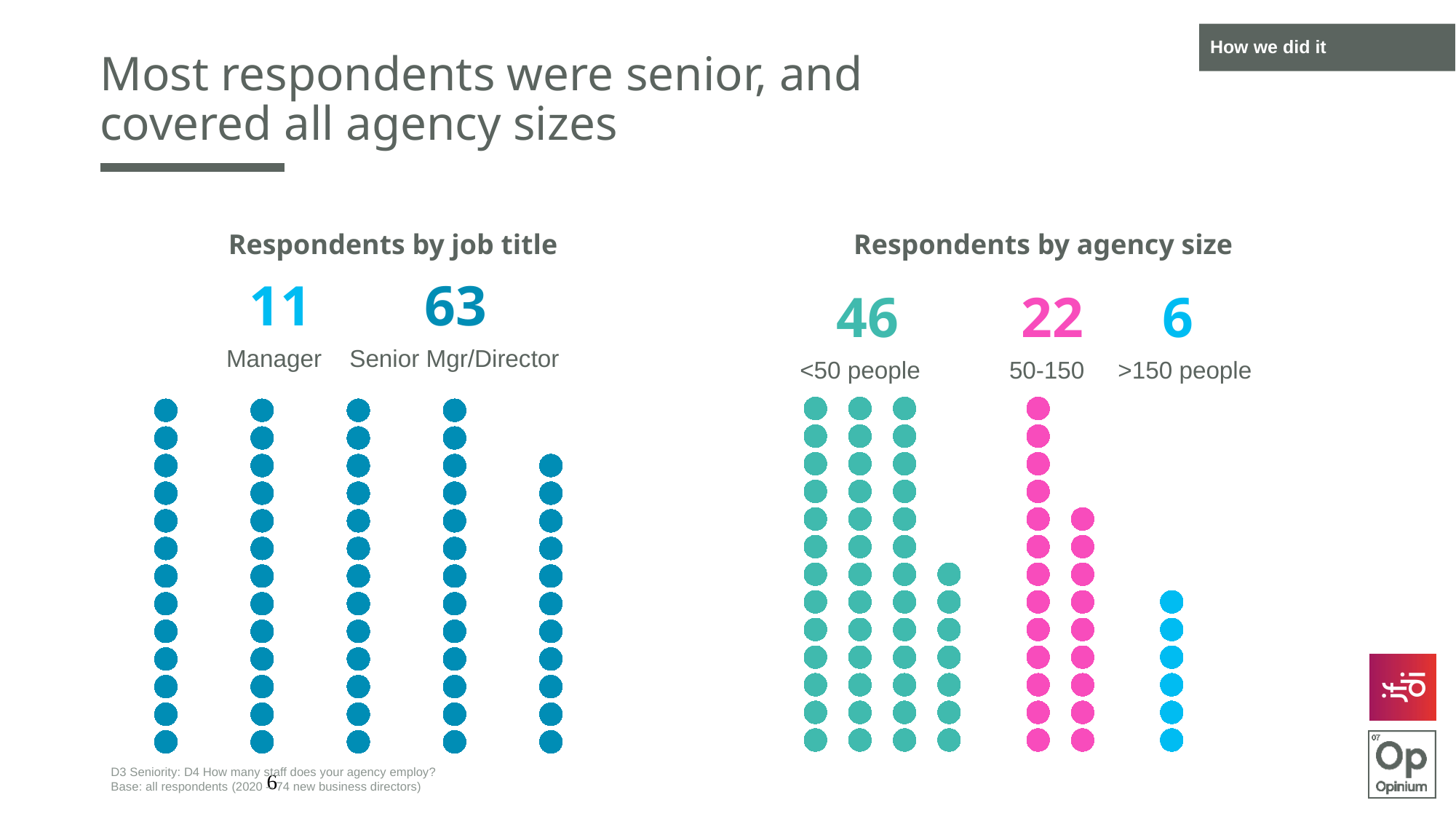
In the 'Respondents by agency size' chart, how many respondents came from agencies with <50 people? 46 What kind of chart is used on this slide to show the respondents? Pictogram (dot) chart In the 'Respondents by job title' chart, how many respondents were Managers? 11 In the 'Respondents by job title' chart, what is the total number of respondents across both job titles? 74 In the 'Respondents by agency size' chart, how many agency size categories are shown? 3 In the 'Respondents by agency size' chart, how many respondents came from agencies with >150 people? 6 In the 'Respondents by agency size' chart, which agency size category has the fewest respondents? >150 people In the 'Respondents by agency size' chart, how many respondents came from agencies with 50-150 people? 22 In the 'Respondents by agency size' chart, what is the difference between the <50 people and 50-150 categories? 24 In the 'Respondents by job title' chart, how many respondents were Senior Mgr/Director? 63 In the 'Respondents by agency size' chart, which agency size category has the most respondents? <50 people In the 'Respondents by job title' chart, how many more respondents were Senior Mgr/Director than Manager? 52